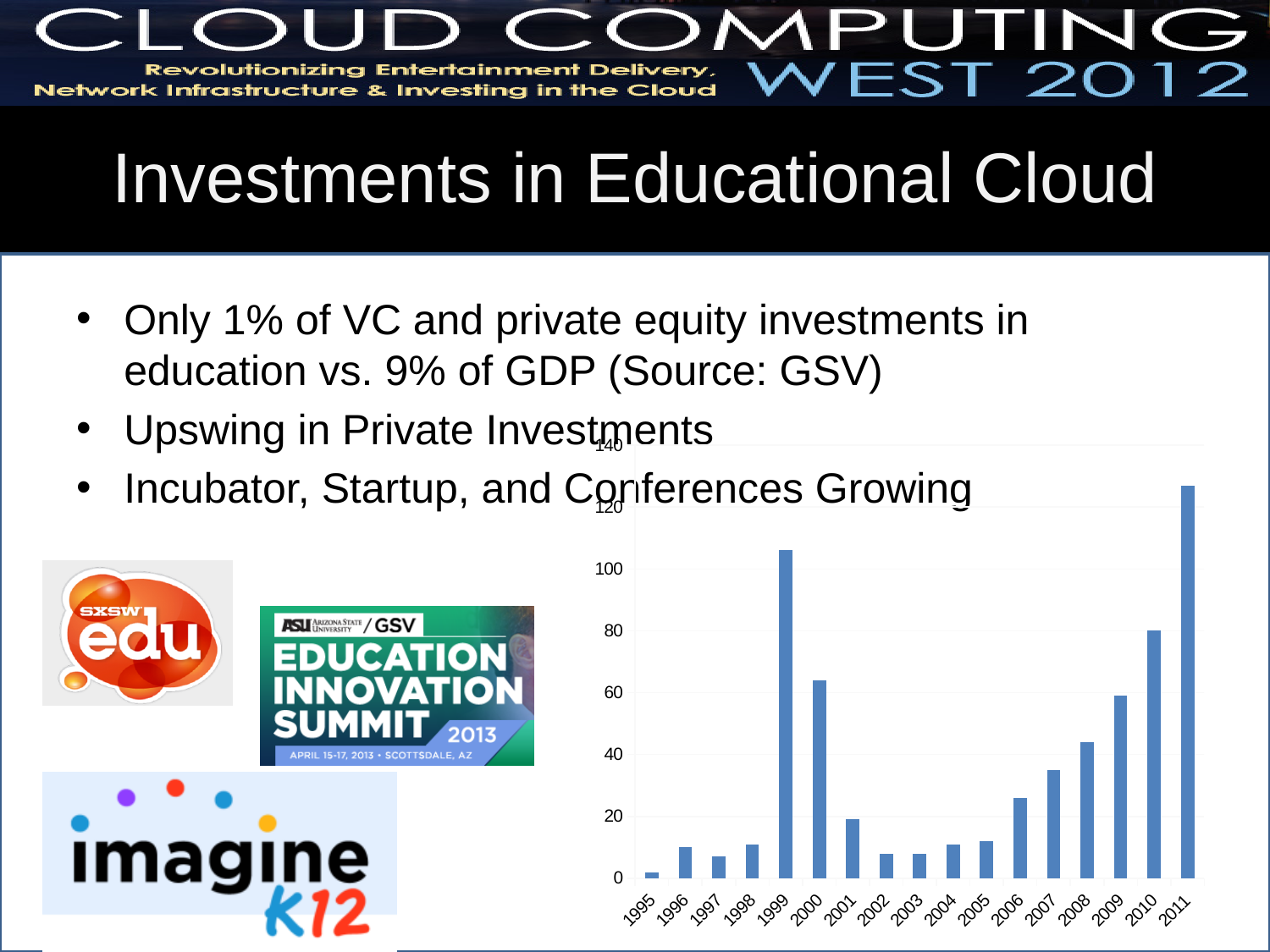
Is the value for 2011 greater or less than 120? greater Which year has the lowest bar in the chart? 1995 Is the value for 2007 greater or less than 40? less Which year has the larger value, 2011 or 1999? 2011 Which year has the highest bar in the chart? 2011 Is the value for 1999 greater or less than 100? greater What kind of chart is shown on the slide? bar chart What is the first year shown on the x axis of the chart? 1995 Which year has the larger value, 1999 or 2000? 1999 How many years are plotted on the x axis of the bar chart? 17 Do the values rise or fall from 2006 to 2011? rise